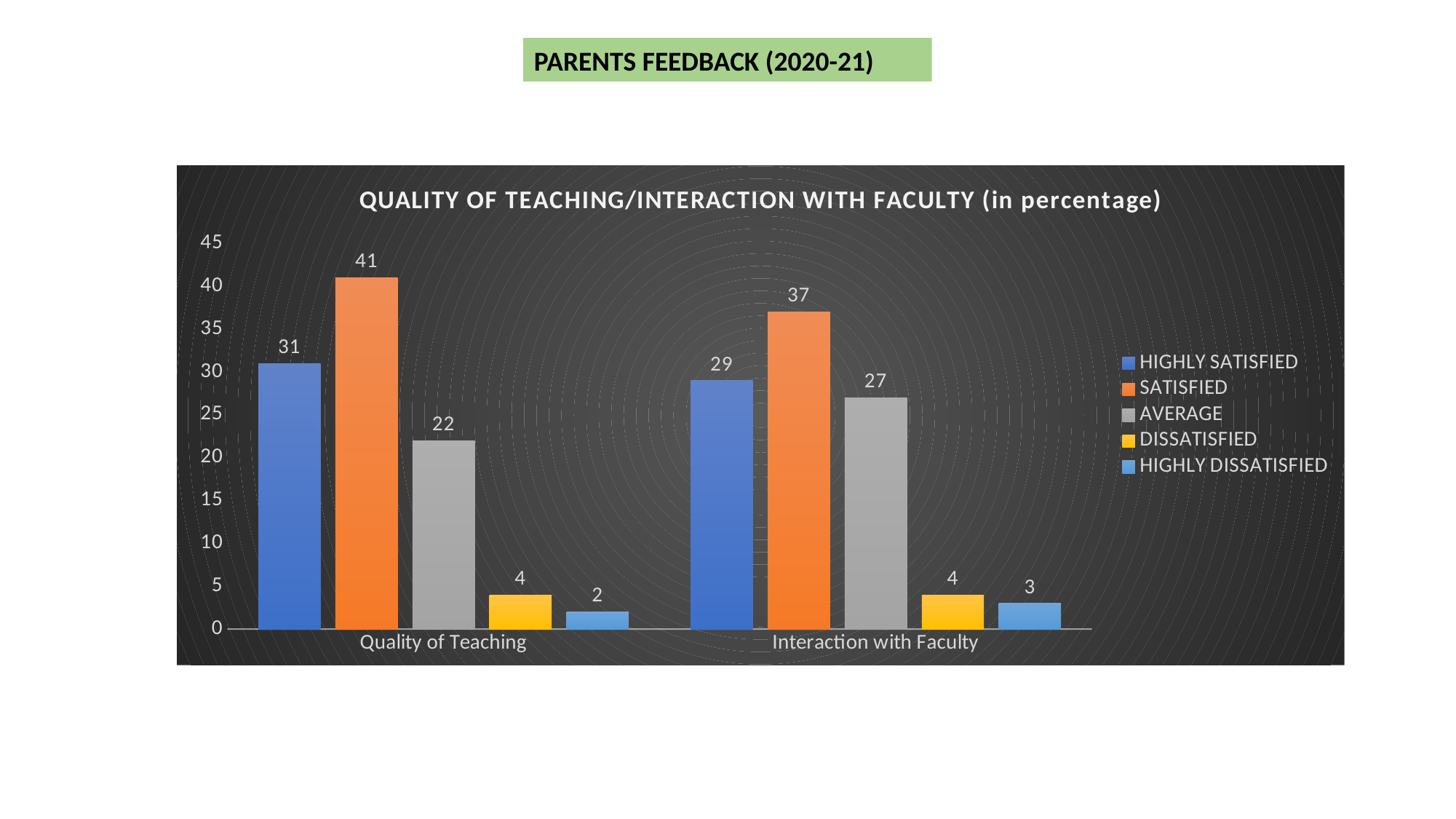
Which is larger: HIGHLY SATISFIED for Quality of Teaching or HIGHLY SATISFIED for Interaction with Faculty? Quality of Teaching How many series does the legend list? 5 What is the title of the chart? QUALITY OF TEACHING/INTERACTION WITH FACULTY (in percentage) What kind of chart is shown on the slide? Bar chart What is the difference between the SATISFIED values for Quality of Teaching and Interaction with Faculty? 4 What is the value for AVERAGE under Interaction with Faculty? 27 What colour represents the DISSATISFIED series? Yellow Which series has the highest value under Interaction with Faculty? SATISFIED Which series has the lowest value under Quality of Teaching? HIGHLY DISSATISFIED What is the value for HIGHLY DISSATISFIED under Quality of Teaching? 2 What is the value for SATISFIED under Quality of Teaching? 41 How many categories are shown on the x axis? 2